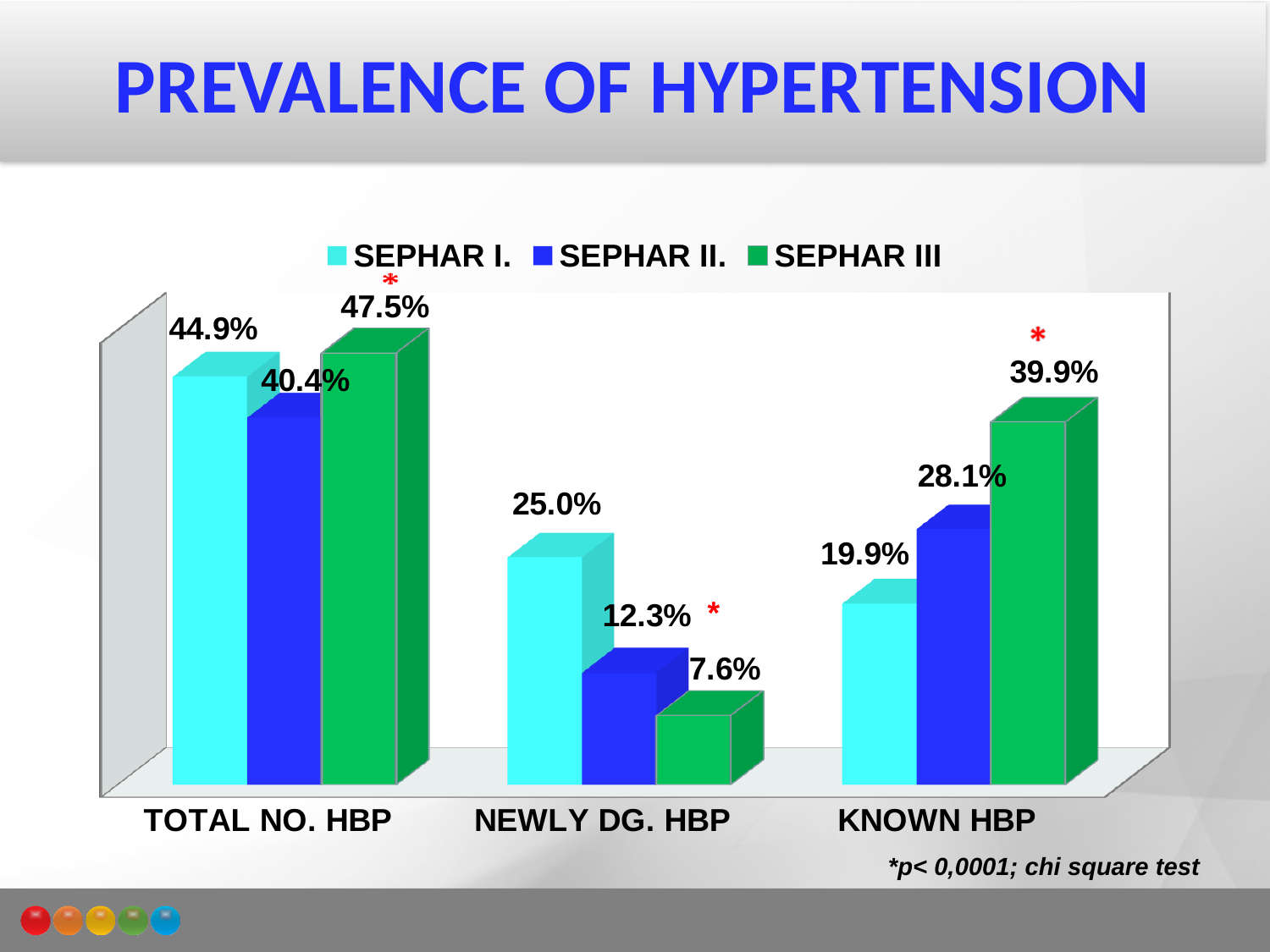
What kind of chart is shown on the slide? Bar chart What is the title of the slide? PREVALENCE OF HYPERTENSION What is the value for SEPHAR I. in the TOTAL NO. HBP category? 44.9% Which is larger: the SEPHAR I. value for NEWLY DG. HBP or the SEPHAR I. value for KNOWN HBP? NEWLY DG. HBP How many series does the legend list? 3 Which series has the lowest value in the NEWLY DG. HBP category? SEPHAR III What is the difference between the SEPHAR III and SEPHAR I. values in the KNOWN HBP category? 20.0% How many categories are shown on the x axis? 3 Do the SEPHAR III values rise or fall from TOTAL NO. HBP to NEWLY DG. HBP? Fall What is the value for SEPHAR II. in the NEWLY DG. HBP category? 12.3% Which series has the highest value in the TOTAL NO. HBP category? SEPHAR III What is the value for SEPHAR III in the KNOWN HBP category? 39.9%